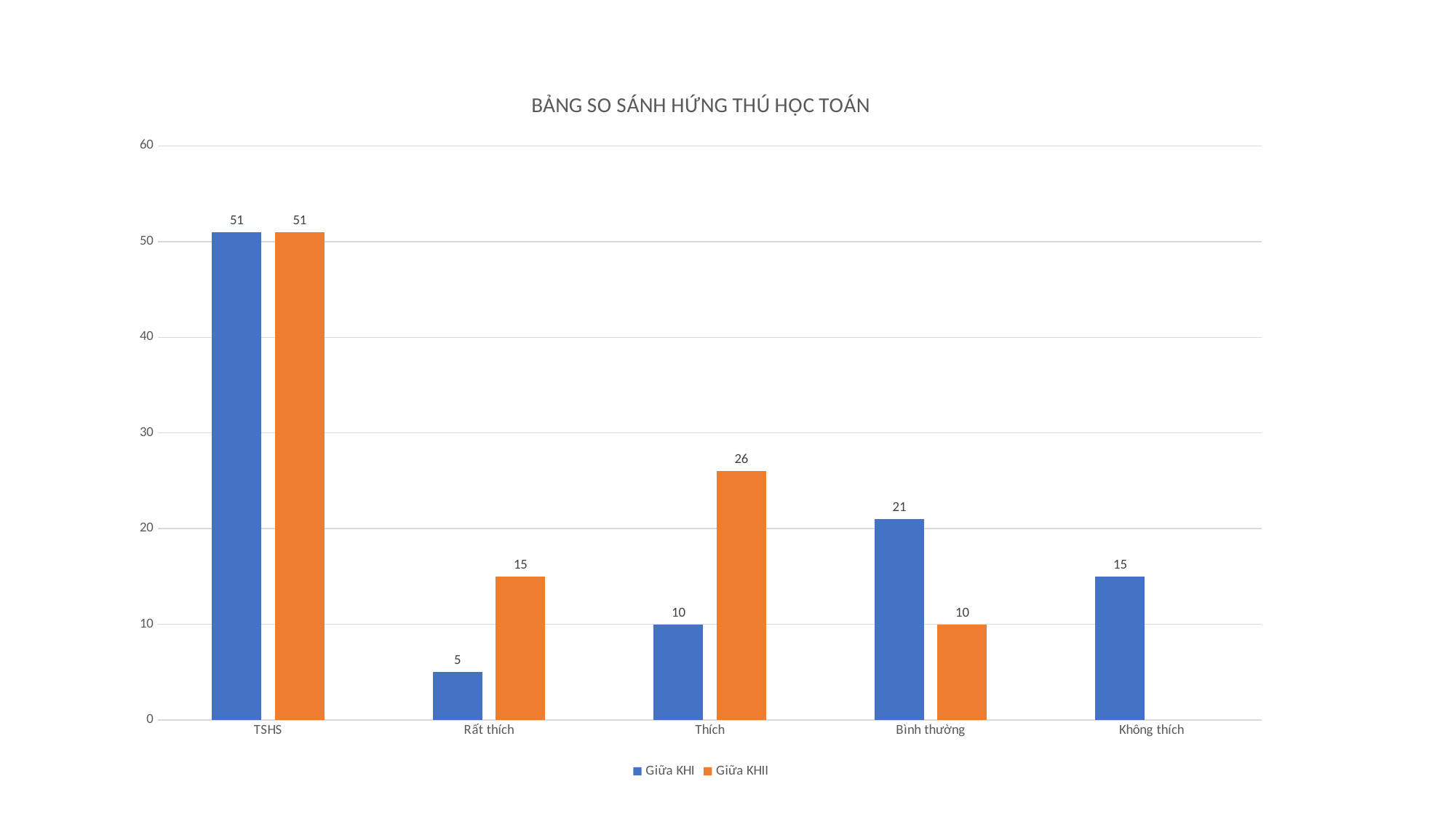
Which category has the lowest value for Giữa KHI? Rất thích What is the value for Giữa KHII in the Rất thích category? 15 What is the difference between Giữa KHII and Giữa KHI in the Thích category? 16 In the Bình thường category, which series has the larger value, Giữa KHI or Giữa KHII? Giữa KHI How many categories are shown on the x axis? 5 How many series does the legend list? 2 What kind of chart is shown on the slide? Bar chart What colour are the bars for the Giữa KHII series? Orange Which category has the highest value for Giữa KHII? TSHS What is the value for Giữa KHI in the Thích category? 10 What is the value for Giữa KHI in the Không thích category? 15 What is the title of the chart? BẢNG SO SÁNH HỨNG THÚ HỌC TOÁN